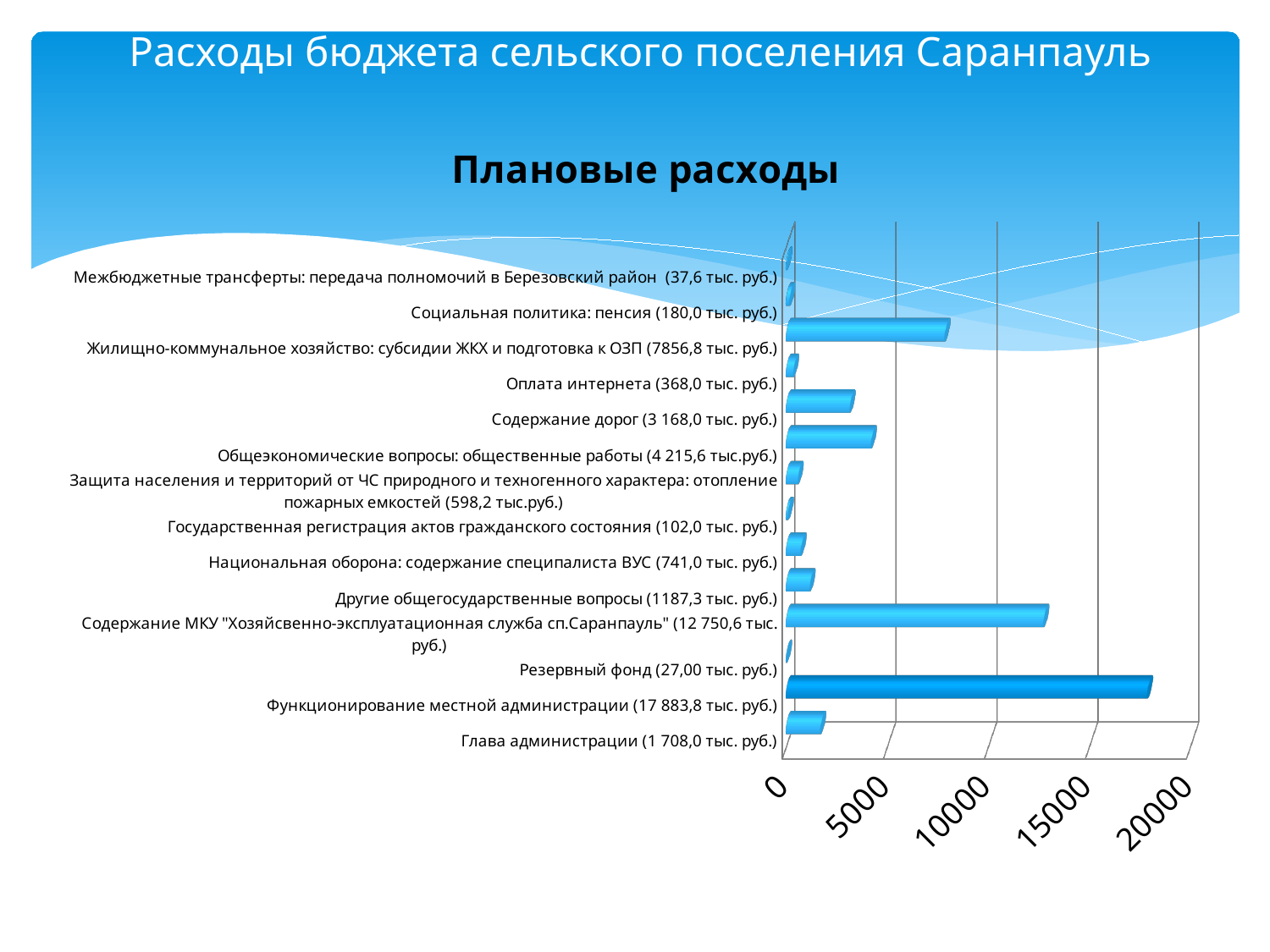
What type of chart is shown on the slide? Bar chart Which category has the lowest planned expenditure? Резервный фонд Is the value for Функционирование местной администрации greater or less than 15000? greater What is the difference between the expenditure for Функционирование местной администрации and for Содержание МКУ "Хозяйсвенно-эксплуатационная служба сп.Саранпауль"? 5 133,2 тыс. руб. What is the title of the chart? Плановые расходы What is the planned expenditure for Содержание дорог? 3 168,0 тыс. руб. What is the planned expenditure for Резервный фонд? 27,00 тыс. руб. Which is larger: the expenditure for Жилищно-коммунальное хозяйство or for Содержание МКУ "Хозяйсвенно-эксплуатационная служба сп.Саранпауль"? Содержание МКУ "Хозяйсвенно-эксплуатационная служба сп.Саранпауль" What is the planned expenditure for Функционирование местной администрации? 17 883,8 тыс. руб. Is the value for Содержание дорог greater or less than 5000? less Which category has the highest planned expenditure? Функционирование местной администрации How many categories are plotted in the chart? 14